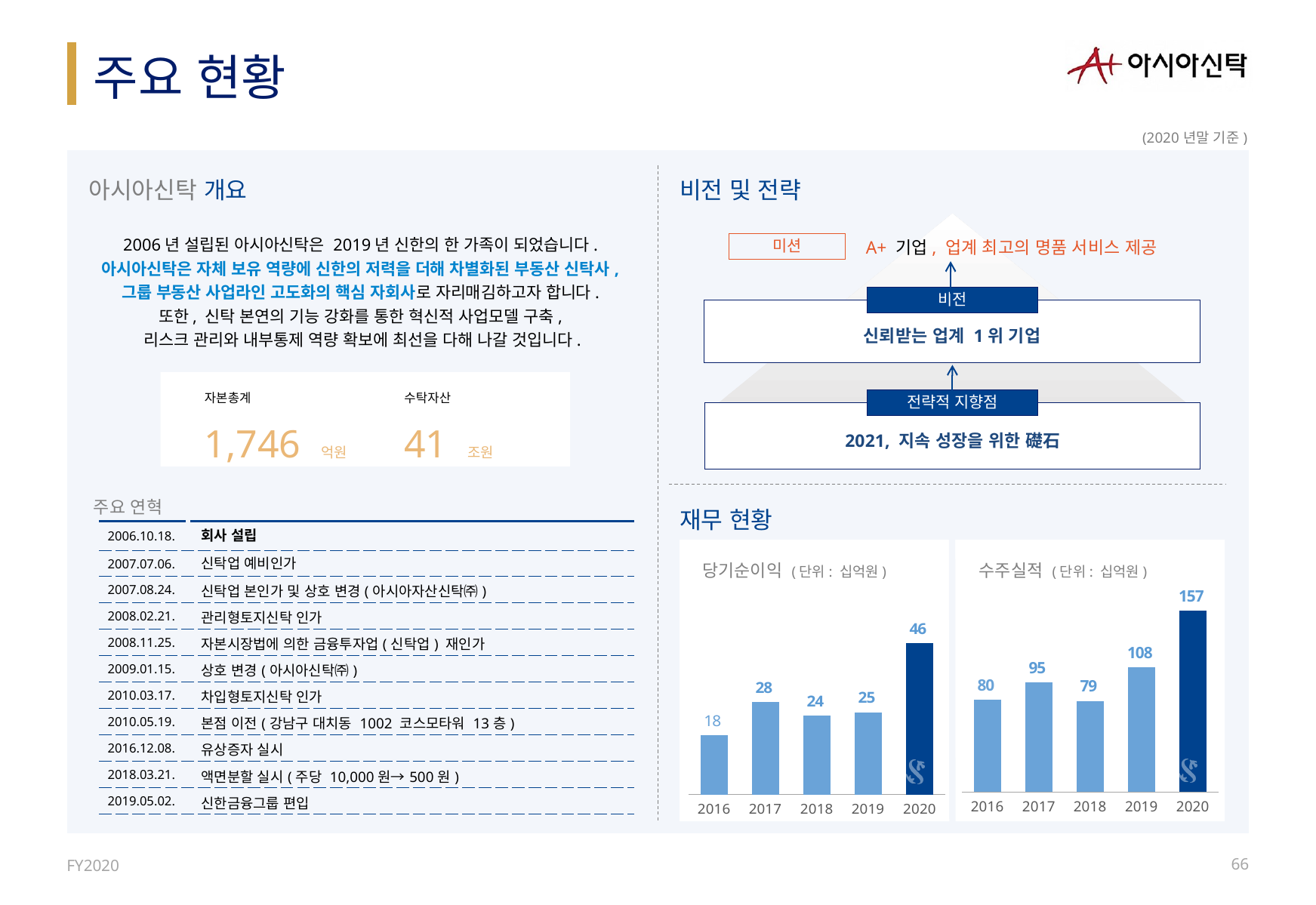
In the 당기순이익 chart, which year has the lowest value? 2016 In the 수주실적 chart, which year has the lowest value? 2018 How many years are shown in the 수주실적 chart? 5 In the 수주실적 chart, what is the value for 2019? 108 What type of chart is the 당기순이익 chart? Bar chart What unit is stated in the title of the 수주실적 chart? 십억원 In the 수주실적 chart, which year has the highest value? 2020 In the 당기순이익 chart, what is the value for 2016? 18 In the 당기순이익 chart, what is the difference between the 2020 value and the 2019 value? 21 In the 수주실적 chart, what is the difference between the 2020 value and the 2016 value? 77 In the 당기순이익 chart, what is the value for 2020? 46 In the 당기순이익 chart, which is larger, the value for 2017 or the value for 2018? 2017